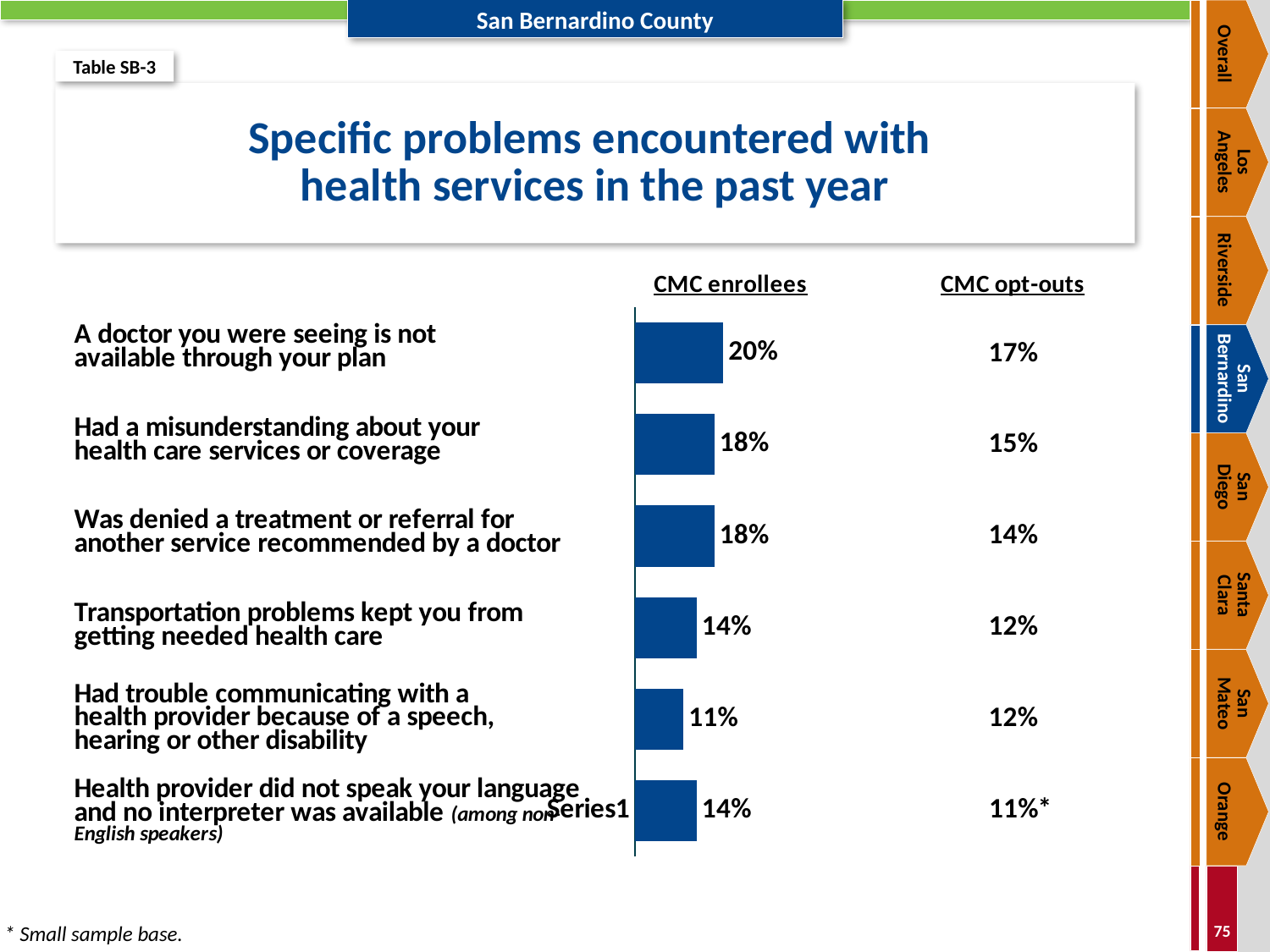
What percentage of CMC enrollees had a misunderstanding about their health care services or coverage? 18% What percentage of CMC enrollees had trouble communicating with a health provider because of a speech, hearing or other disability? 11% Which problem has the highest percentage among CMC enrollees? A doctor you were seeing is not available through your plan What is the CMC opt-outs value shown for 'Was denied a treatment or referral for another service recommended by a doctor'? 14% Which problem has the lowest percentage among CMC enrollees? Had trouble communicating with a health provider because of a speech, hearing or other disability What percentage of CMC enrollees reported that a doctor they were seeing is not available through their plan? 20% What type of chart is shown on the slide? bar chart What is the difference between the highest and lowest CMC enrollee percentages in the chart? 9 percentage points Among CMC enrollees, which is larger: the percentage for 'A doctor you were seeing is not available through your plan' or for 'Transportation problems kept you from getting needed health care'? A doctor you were seeing is not available through your plan What is the title of the chart? Specific problems encountered with health services in the past year What percentage of CMC enrollees reported transportation problems kept them from getting needed health care? 14% How many problem categories are plotted in the bar chart? 6